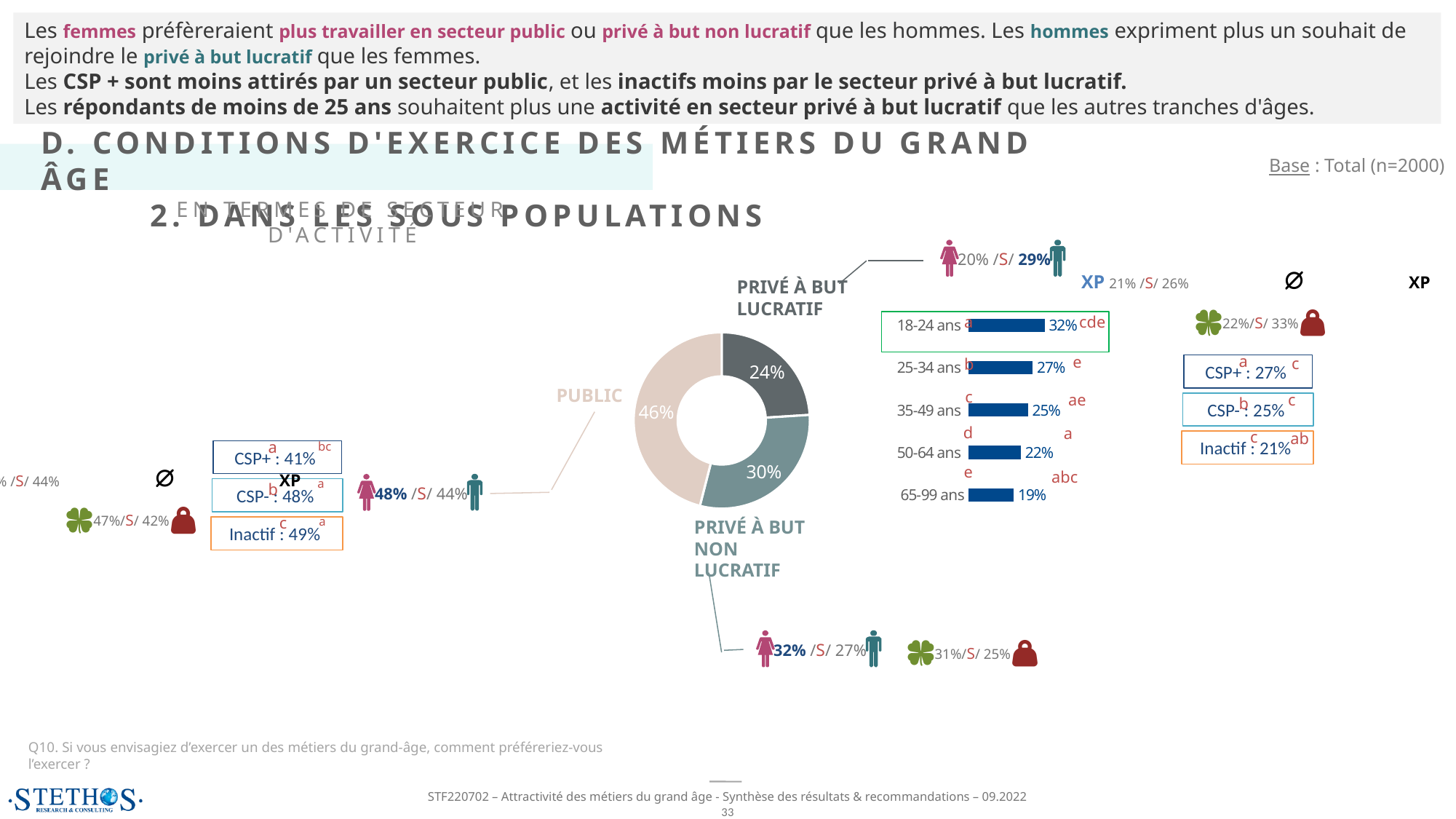
In the donut chart, which sector has the largest share? PUBLIC In the bar chart by age group, do the values rise or fall as age increases from 18-24 ans to 65-99 ans? Fall In the donut chart, what share of respondents prefer the PUBLIC sector? 46% In the donut chart, what share of respondents prefer the PRIVÉ À BUT LUCRATIF sector? 24% In the bar chart by age group, which age group has the highest value? 18-24 ans In the bar chart by age group, what is the value for 65-99 ans? 19% In the donut chart, what share of respondents prefer the PRIVÉ À BUT NON LUCRATIF sector? 30% What kind of chart shows the split between PUBLIC, PRIVÉ À BUT LUCRATIF and PRIVÉ À BUT NON LUCRATIF? Donut (pie) chart In the bar chart by age group, what is the value for 18-24 ans? 32% In the donut chart, what is the difference between the PUBLIC share and the PRIVÉ À BUT NON LUCRATIF share? 16% In the donut chart, which sector has the smallest share? PRIVÉ À BUT LUCRATIF How many slices does the donut chart have? 3